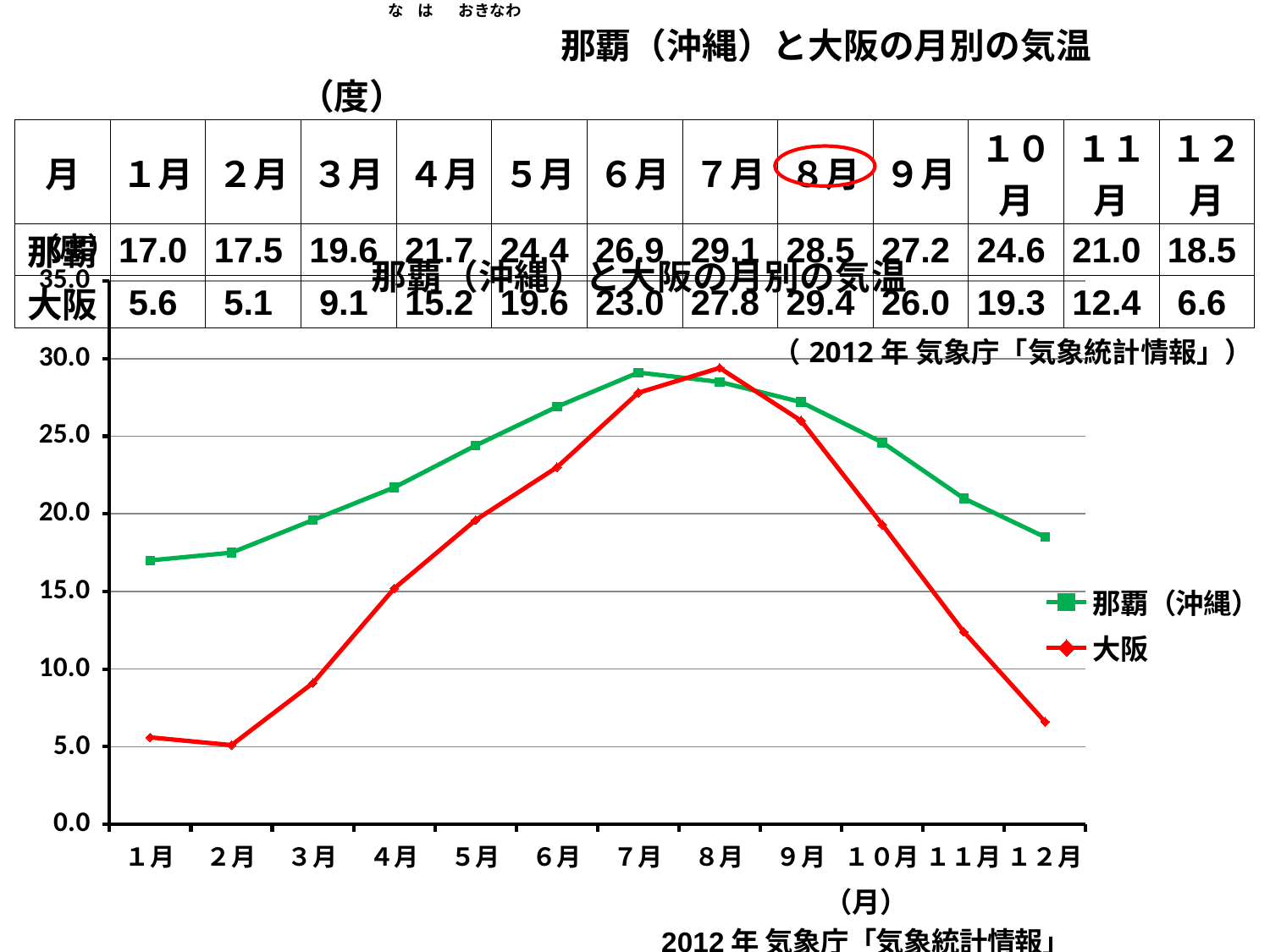
What is the temperature for 大阪 in 1月? 5.6 Which series is drawn in green on the chart? 那覇（沖縄） How many series does the chart legend list? 2 What is the temperature for 那覇 in 8月? 28.5 Which is higher in 8月, the 那覇 temperature or the 大阪 temperature? 大阪 How many months are plotted along the x axis of the chart? 12 Is the 大阪 temperature in 4月 greater or less than 20.0? less In which month is the 大阪 temperature lowest? 2月 What is the temperature for 大阪 in 8月? 29.4 What kind of chart is shown on the slide? line chart What is the difference between the 那覇 and 大阪 temperatures in 1月? 11.4 In which month is the 那覇 temperature highest? 7月